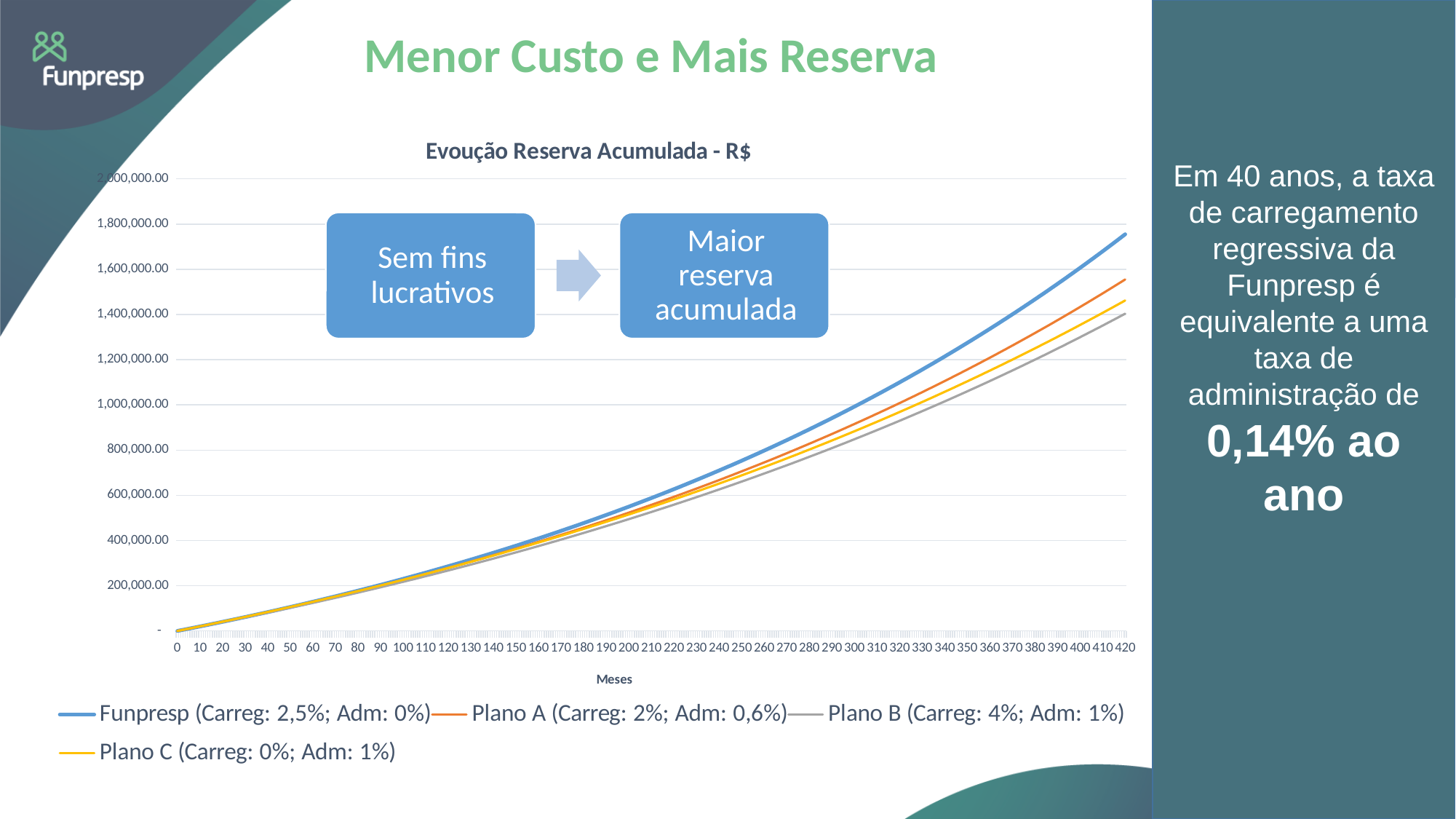
Which series has the highest value at 420 months? Funpresp (Carreg: 2,5%; Adm: 0%) How many series does the legend list? 4 Is the value of the Funpresp series at 420 months greater or less than 2,000,000.00? less Is the value of the Plano B series at 420 months greater or less than 1,200,000.00? greater Is the value of the Funpresp series at 420 months greater or less than 1,600,000.00? greater Which series has the lowest value at 420 months? Plano B (Carreg: 4%; Adm: 1%) What is the label of the x axis? Meses Do the values of the Funpresp series rise or fall as the months increase? rise What kind of chart is shown on the slide? line chart What is the title of the chart? Evoução Reserva Acumulada - R$ At 420 months, which is larger: the Funpresp series or the Plano B series? Funpresp (Carreg: 2,5%; Adm: 0%)